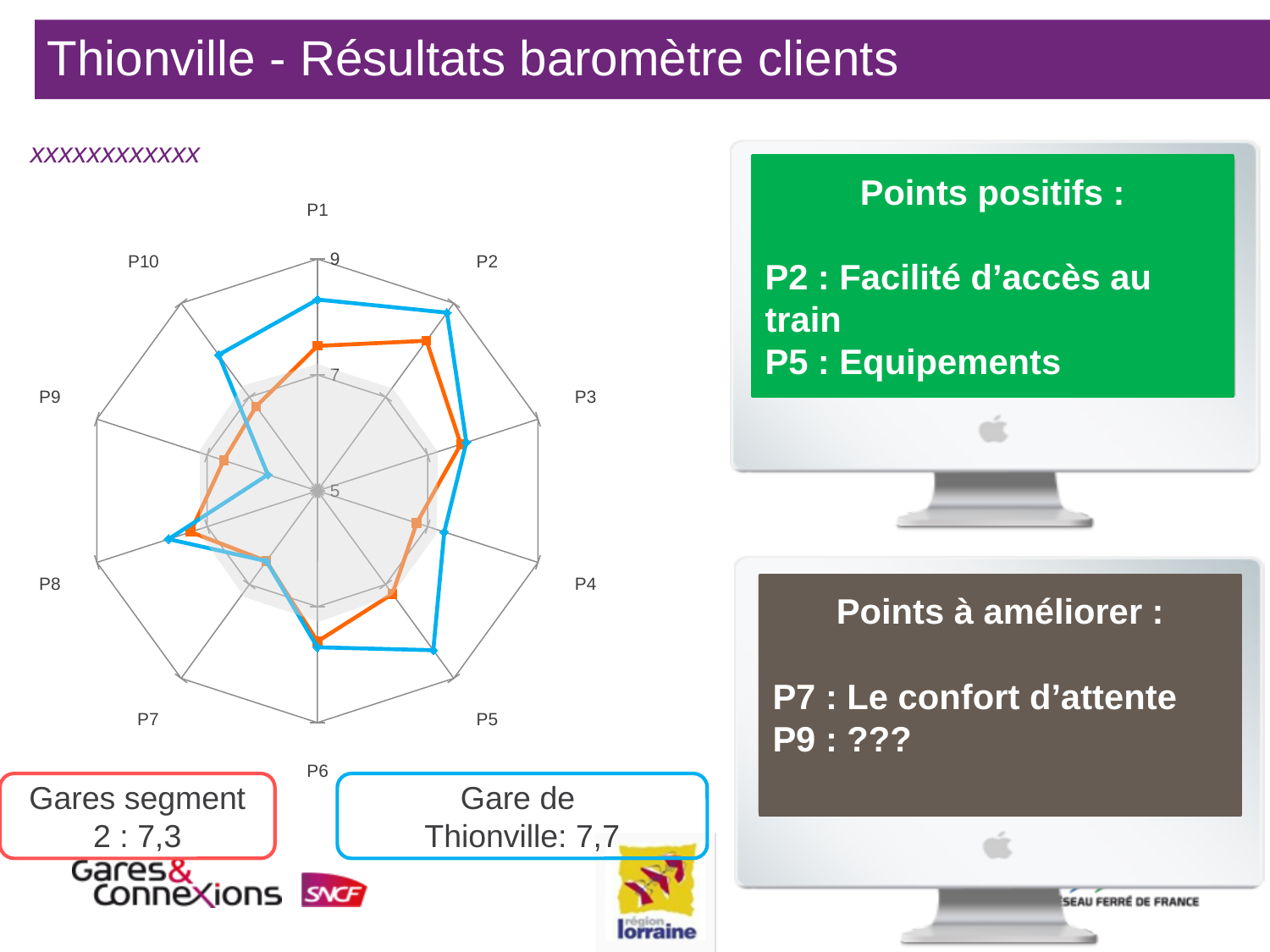
What overall score is given for Gare de Thionville in the box below the chart? 7,7 What kind of chart is shown on the slide? radar chart At P9, which series has the larger value, Gare de Thionville (blue) or Gares segment 2 (orange)? Gares segment 2 (orange) Is the value for Gare de Thionville (blue) at P2 greater or less than 7? greater Is the value for Gare de Thionville (blue) at P5 greater or less than 7? greater What is the highest value shown on the radar chart's scale? 9 At P2, which series has the larger value, Gare de Thionville (blue) or Gares segment 2 (orange)? Gare de Thionville (blue) How many data series are plotted on the radar chart? 2 How many categories (axes) does the radar chart have? 10 For the Gare de Thionville (blue) series, which category has the lowest value? P9 Is the value for Gare de Thionville (blue) at P9 greater or less than 7? less